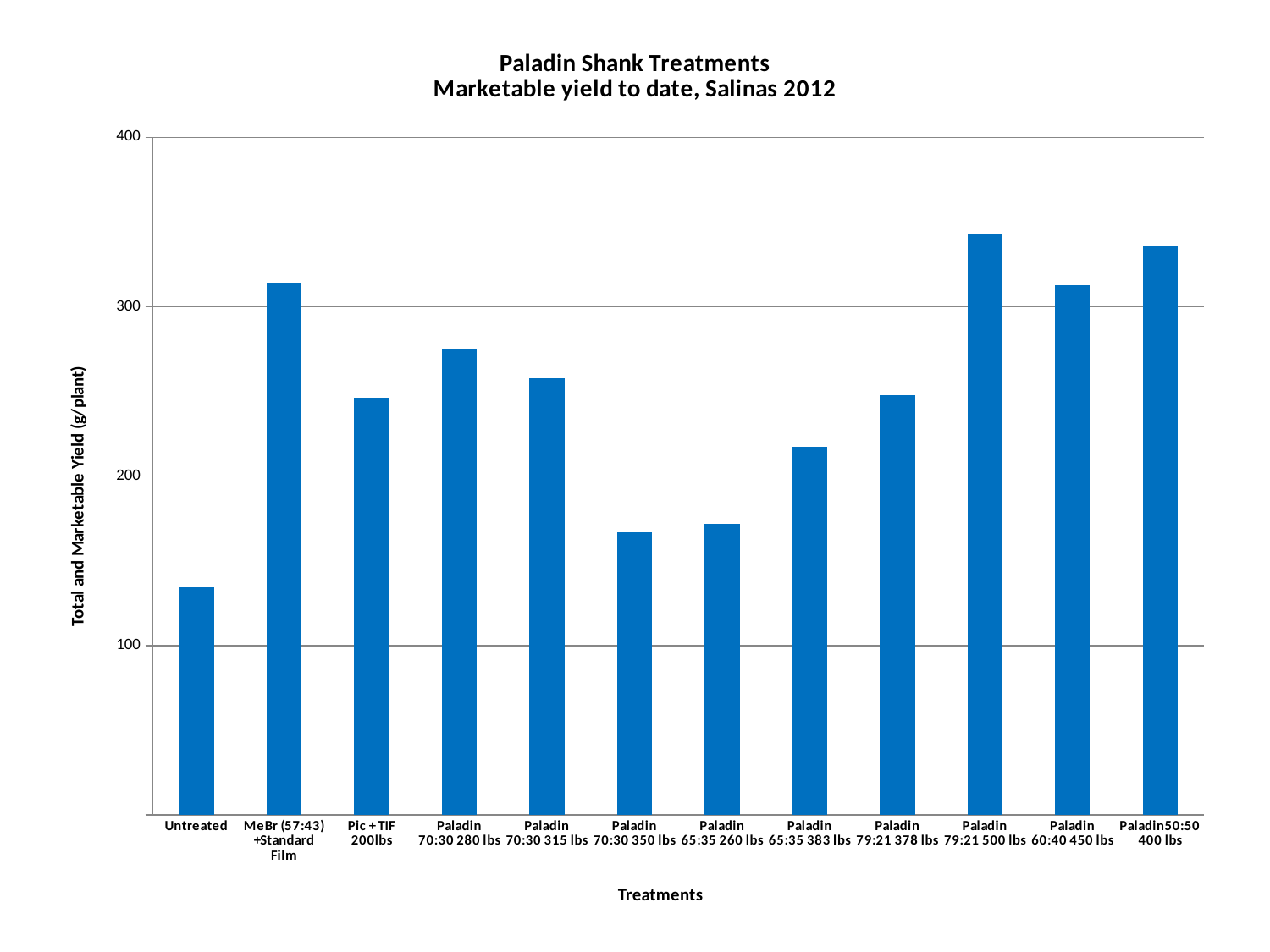
Is the value for Pic + TIF 200lbs greater or less than 200? greater Which has a higher marketable yield, Paladin 70:30 280 lbs or Paladin 70:30 350 lbs? Paladin 70:30 280 lbs Which treatment has the lowest marketable yield? Untreated Which has a higher marketable yield, MeBr (57:43) +Standard Film or Untreated? MeBr (57:43) +Standard Film Is the value for Paladin 70:30 350 lbs greater or less than 200? less What is the title of the chart? Paladin Shank Treatments Marketable yield to date, Salinas 2012 Is the value for Paladin 79:21 500 lbs greater or less than 300? greater How many treatment categories are plotted on the x axis? 12 What is the label on the y axis? Total and Marketable Yield (g/plant) What kind of chart is shown on the slide? bar chart